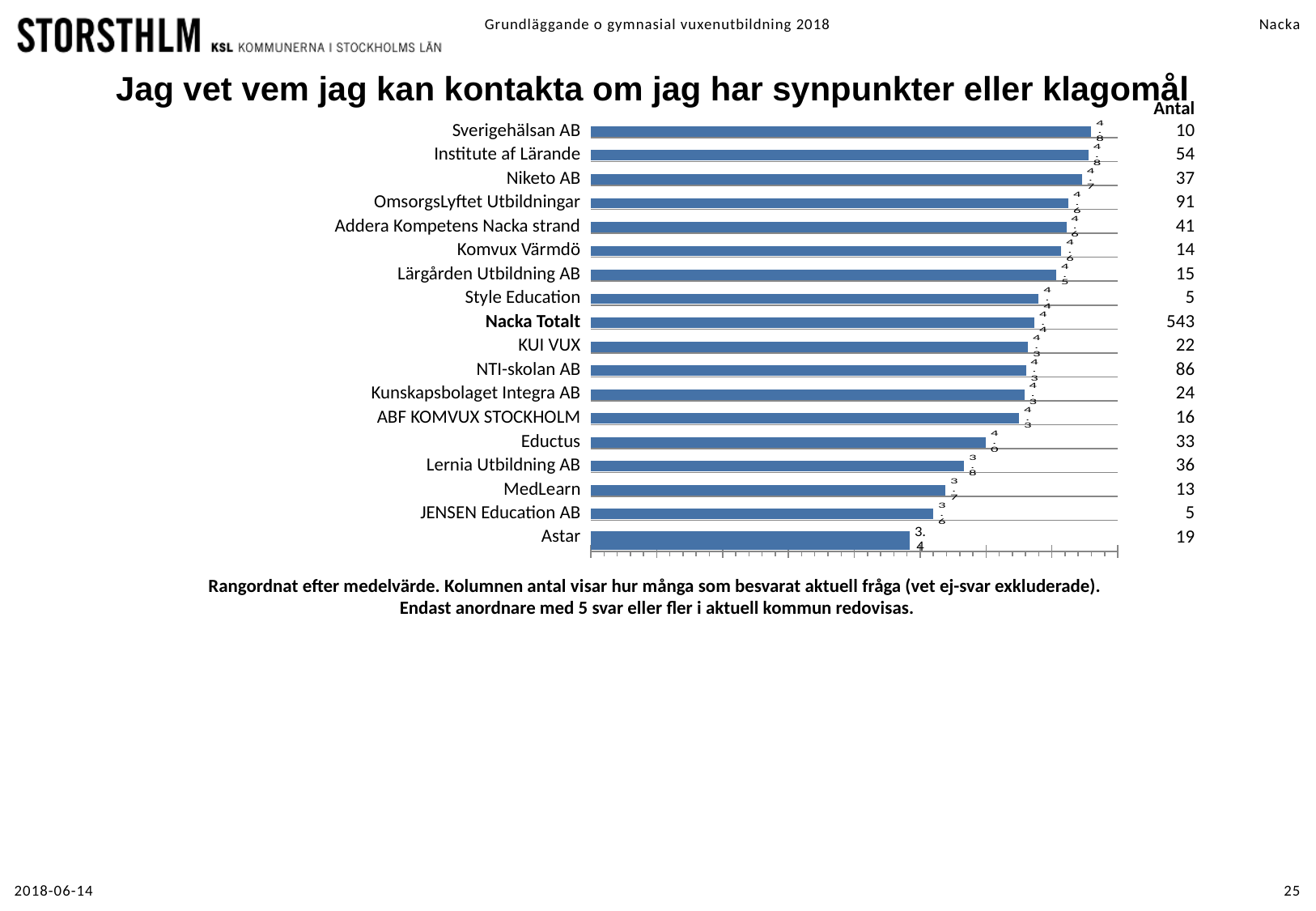
What kind of chart is shown on the slide? bar chart What is the value shown for Niketo AB? 4.7 Which category has the shortest bar in the chart? Astar Which has a longer bar, Lernia Utbildning AB or MedLearn? Lernia Utbildning AB Which has a longer bar, Astar or Sverigehälsan AB? Sverigehälsan AB What is the value shown for Nacka Totalt? 4.4 What is the value shown for Eductus? 4.0 What is the difference between the values for Sverigehälsan AB and Astar? 1.4 Which category has the longest bar in the chart? Sverigehälsan AB What is the title of the chart? Jag vet vem jag kan kontakta om jag har synpunkter eller klagomål What is the value shown for Astar? 3.4 How many categories (bars) does the chart show? 18